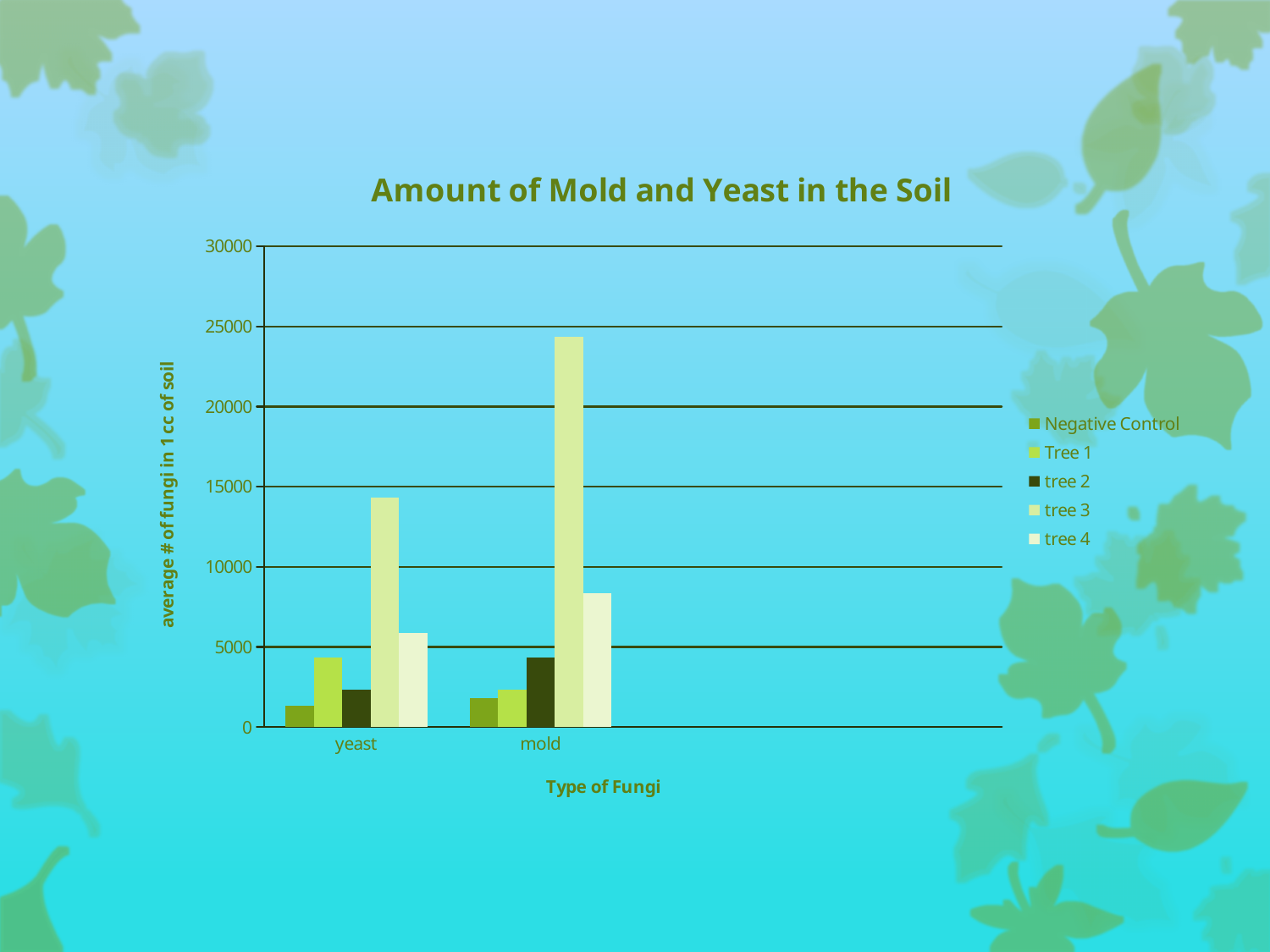
Is the value for tree 3 for mold greater or less than 20000? greater What kind of chart is shown on the slide? bar chart Is the value for tree 3 for yeast greater or less than 10000? greater How many series does the legend list? 5 What is the label of the x axis? Type of Fungi Which series has the highest value for mold? tree 3 Is the value for tree 4 for yeast greater or less than 10000? less How many categories are shown on the x axis? 2 Which is larger for mold: the value for tree 2 or the value for Tree 1? tree 2 What is the title of the chart? Amount of Mold and Yeast in the Soil Which series has the lowest value for yeast? Negative Control Which series has the highest value for yeast? tree 3